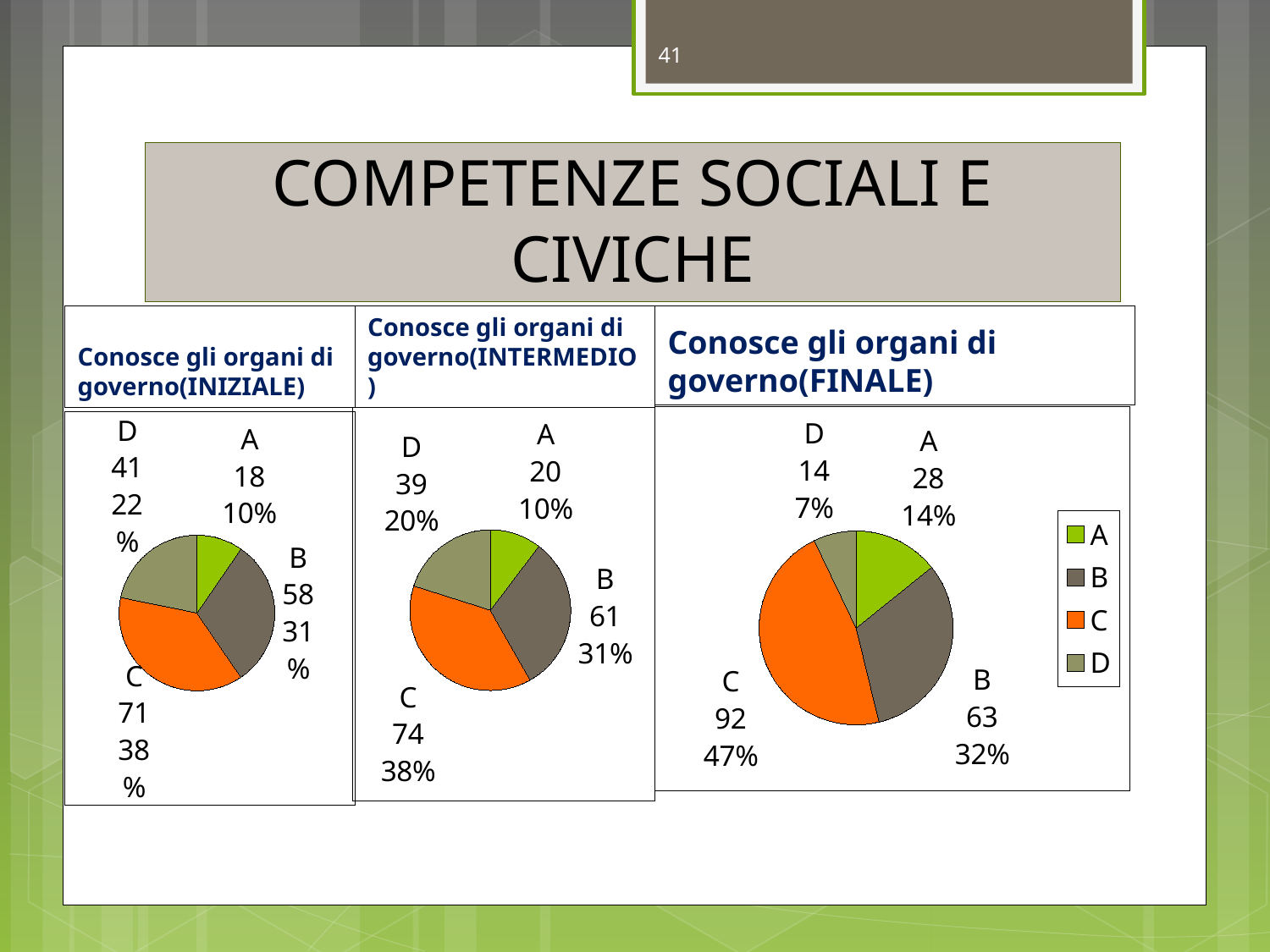
In the 'Conosce gli organi di governo(FINALE)' chart, what is the difference between the values for C and B? 29 In the 'Conosce gli organi di governo(INIZIALE)' chart, what value is shown for category C? 71 How many categories does the 'Conosce gli organi di governo(INTERMEDIO)' pie chart have? 4 How many entries does the legend of the 'Conosce gli organi di governo(FINALE)' chart list? 4 In the 'Conosce gli organi di governo(FINALE)' chart, which category has the smallest slice? D What kind of chart is used for 'Conosce gli organi di governo(FINALE)'? Pie chart In the 'Conosce gli organi di governo(INTERMEDIO)' chart, what value is shown for category B? 61 In the 'Conosce gli organi di governo(FINALE)' chart, what value is shown for category C? 92 In the 'Conosce gli organi di governo(FINALE)' chart, what percentage share does slice A have? 14% In the 'Conosce gli organi di governo(INIZIALE)' chart, which is larger, the value for B or the value for D? B In the 'Conosce gli organi di governo(INIZIALE)' chart, what percentage share does slice D have? 22% In the 'Conosce gli organi di governo(INTERMEDIO)' chart, which category has the largest slice? C